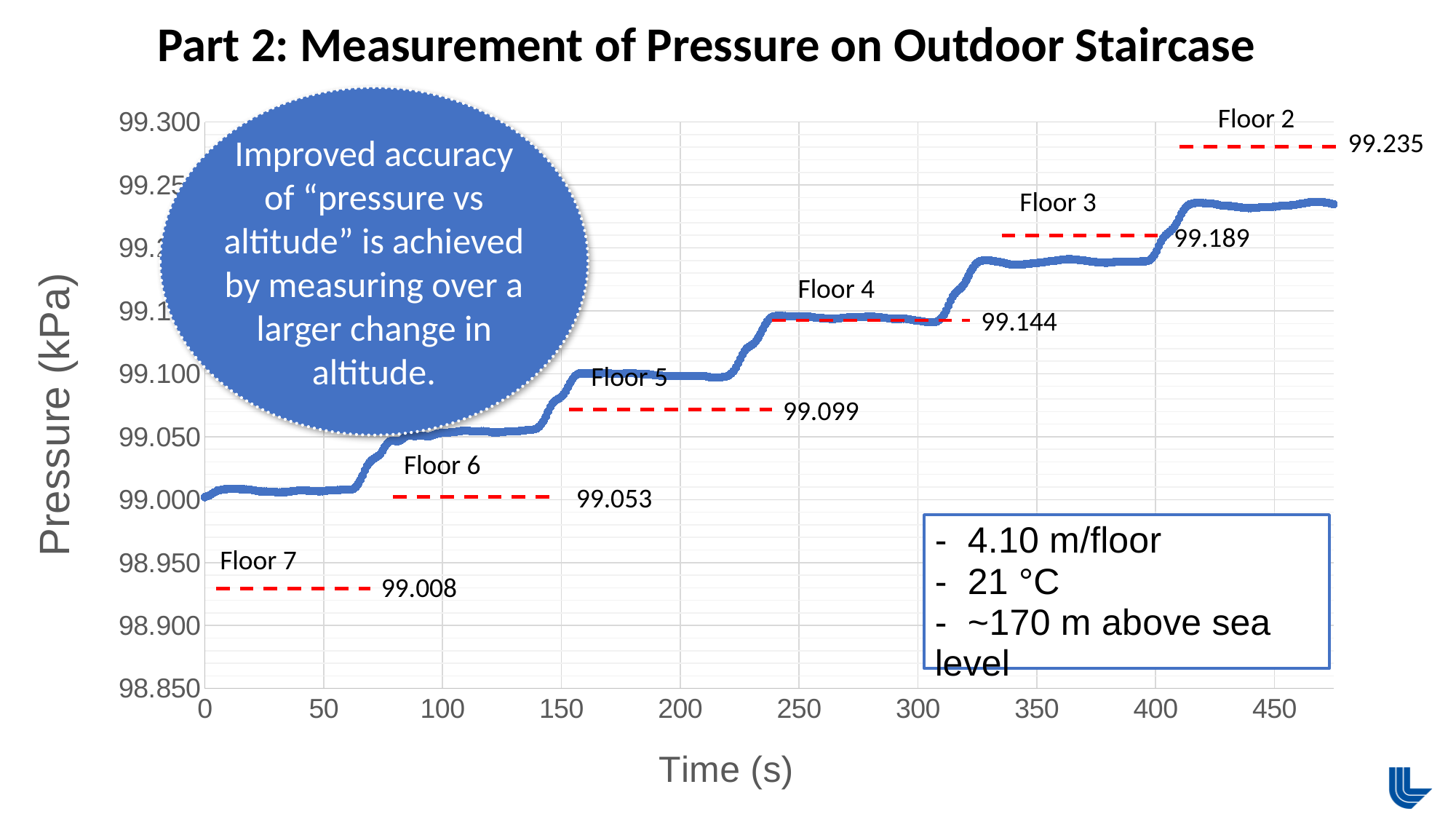
What is the difference between the annotated pressures for Floor 5 and Floor 6? 0.046 What kind of chart is shown on the slide? line chart What is the label of the x axis? Time (s) How many floors are annotated on the chart? 6 What is the difference between the annotated pressures for Floor 2 and Floor 7? 0.227 Which floor has the highest annotated pressure? Floor 2 What pressure value is annotated for Floor 2? 99.235 What pressure value is annotated for Floor 7? 99.008 Which floor has the lowest annotated pressure? Floor 7 What pressure value is annotated for Floor 4? 99.144 Does the pressure rise or fall as time increases along the x axis? rises Which has a higher annotated pressure, Floor 3 or Floor 5? Floor 3